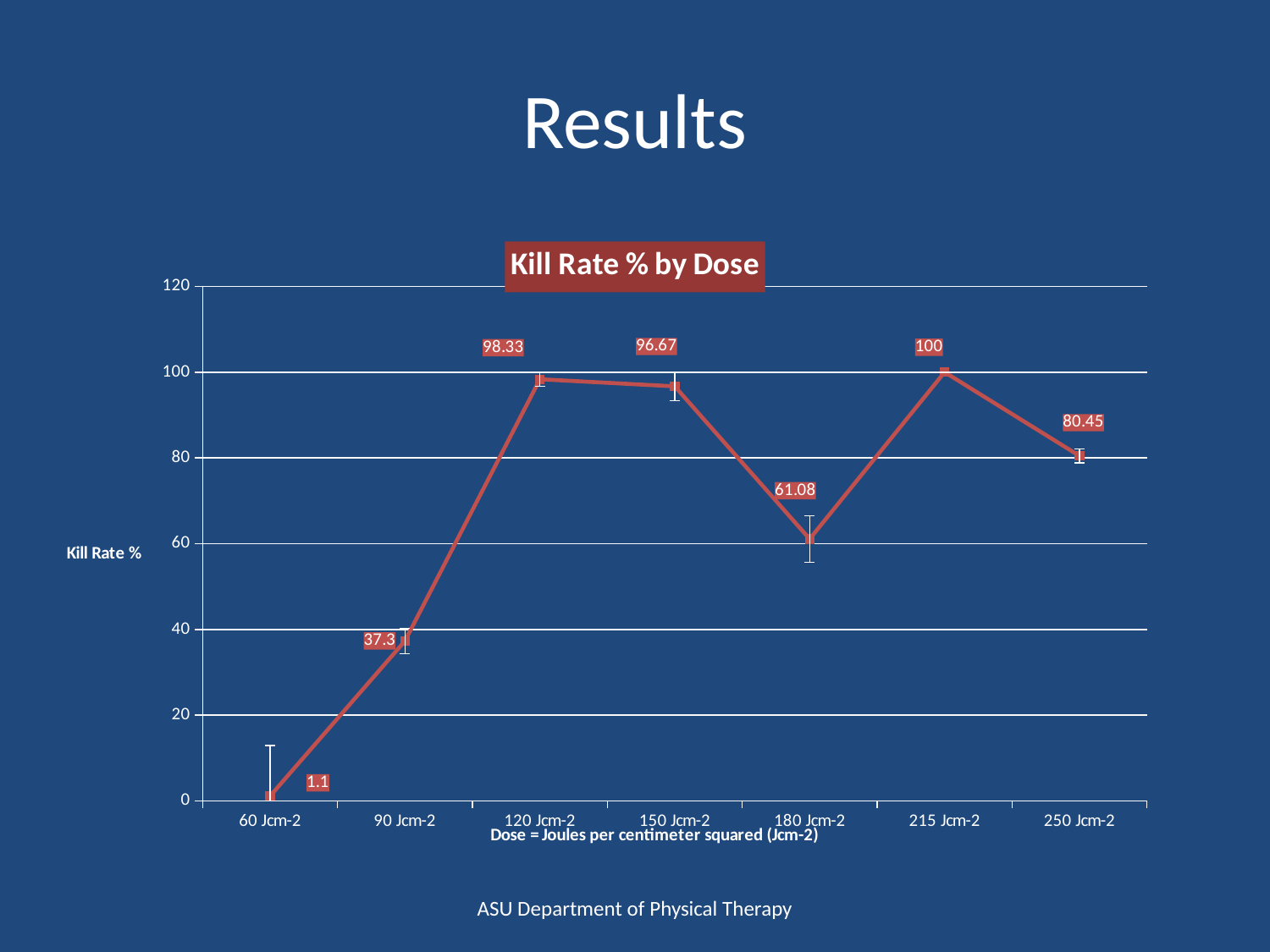
Which dose has the highest kill rate %? 215 Jcm-2 Does the kill rate % rise or fall from 60 Jcm-2 to 120 Jcm-2? Rise What is the difference in kill rate % between 90 Jcm-2 and 60 Jcm-2? 36.2 What kind of chart is shown on the slide? Line chart How many dose levels are plotted on the chart? 7 What is the kill rate % at 120 Jcm-2? 98.33 What is the kill rate % at 180 Jcm-2? 61.08 What is the title of the chart? Kill Rate % by Dose What is the difference in kill rate % between 215 Jcm-2 and 250 Jcm-2? 19.55 Which dose has a higher kill rate %, 150 Jcm-2 or 180 Jcm-2? 150 Jcm-2 What is the kill rate % at 60 Jcm-2? 1.1 Which dose has the lowest kill rate %? 60 Jcm-2